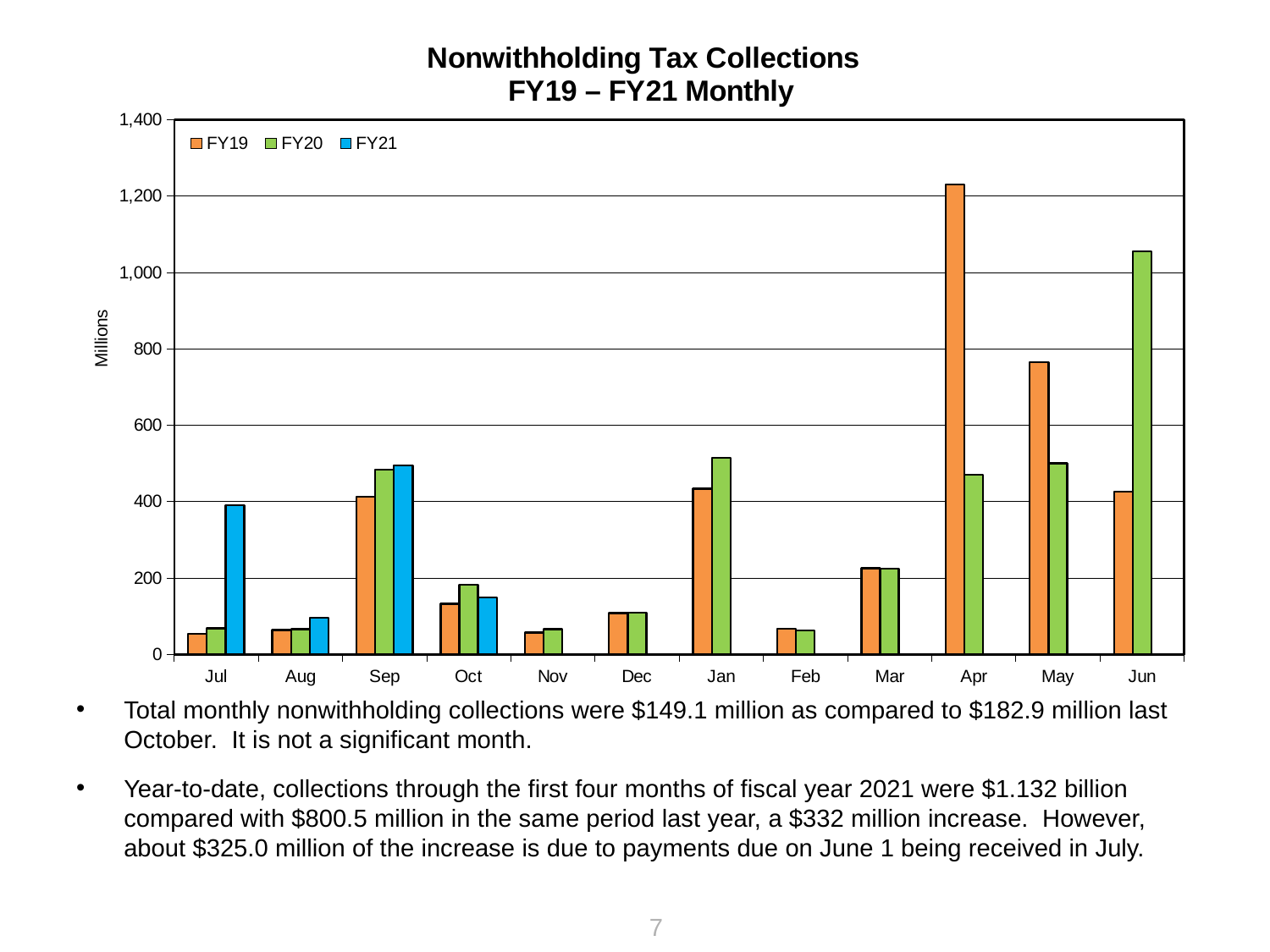
In which month is the FY20 value highest? Jun Is the FY19 value for Apr greater or less than 1,200? greater What is the label on the vertical axis? Millions In which month is the FY21 value highest? Sep How many months are shown along the x axis? 12 Is the FY21 value for Oct greater or less than 200? less In which month is the FY21 value lowest? Aug How many series does the legend list? 3 Is the FY20 value for Jun greater or less than 1,000? greater In which month is the FY19 value highest? Apr In Jul, which series has the larger value, FY19 or FY21? FY21 What kind of chart is shown on the slide? bar chart